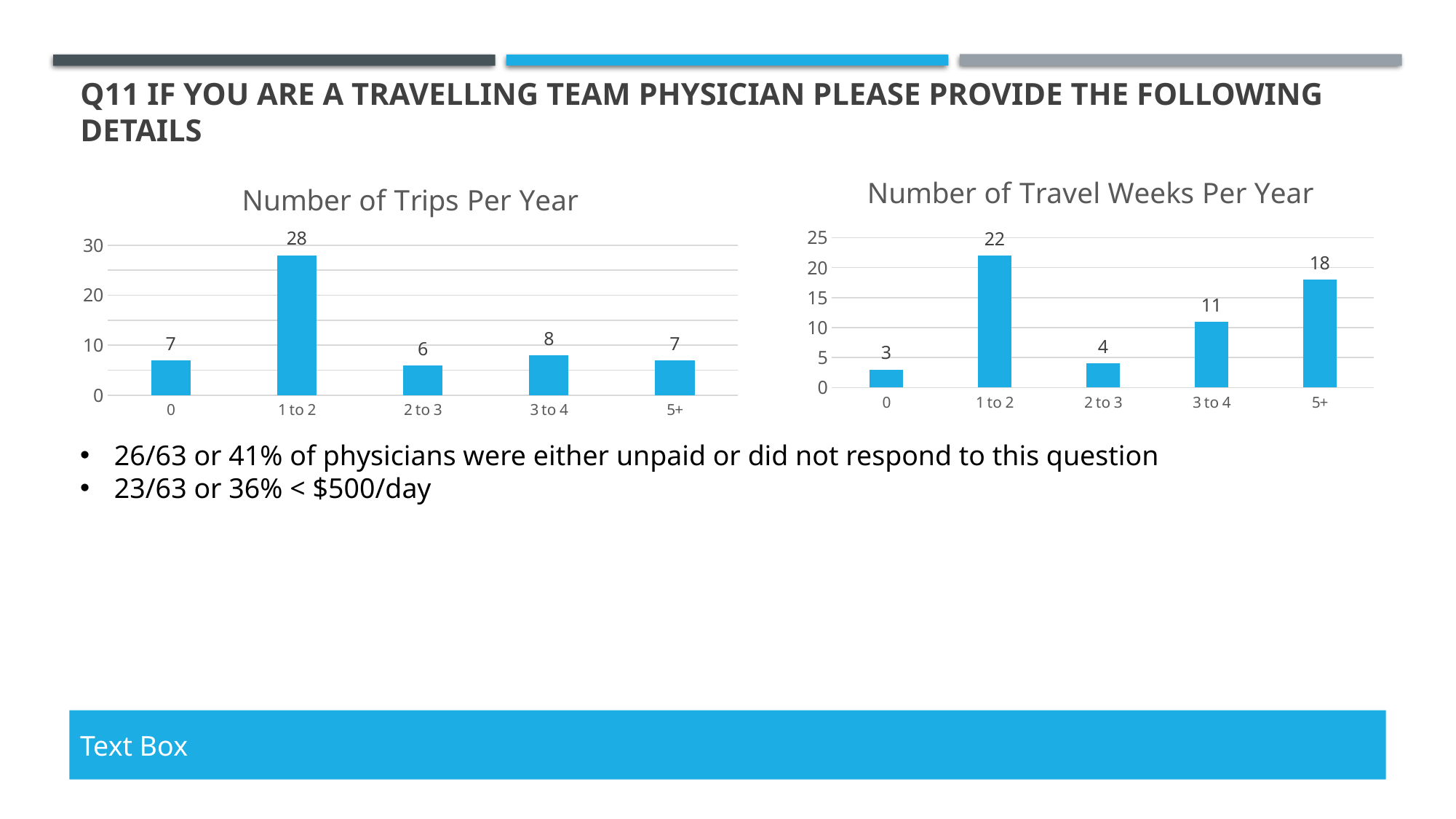
In the 'Number of Travel Weeks Per Year' chart, which is larger, the value for '3 to 4' or the value for '2 to 3'? 3 to 4 In the 'Number of Travel Weeks Per Year' chart, which category has the lowest value? 0 In the 'Number of Trips Per Year' chart, what is the value for the '2 to 3' category? 6 In the 'Number of Trips Per Year' chart, which category has the highest value? 1 to 2 What kind of chart is 'Number of Trips Per Year'? bar chart In the 'Number of Travel Weeks Per Year' chart, what is the difference between the values for '1 to 2' and '5+'? 4 In the 'Number of Trips Per Year' chart, what is the difference between the values for '1 to 2' and '3 to 4'? 20 What is the title of the chart on the right side of the slide? Number of Travel Weeks Per Year How many categories are shown on the x axis of the 'Number of Travel Weeks Per Year' chart? 5 In the 'Number of Trips Per Year' chart, what is the value for the '1 to 2' category? 28 In the 'Number of Travel Weeks Per Year' chart, what is the value for the '5+' category? 18 In the 'Number of Trips Per Year' chart, is the value for '1 to 2' greater or less than 20? greater